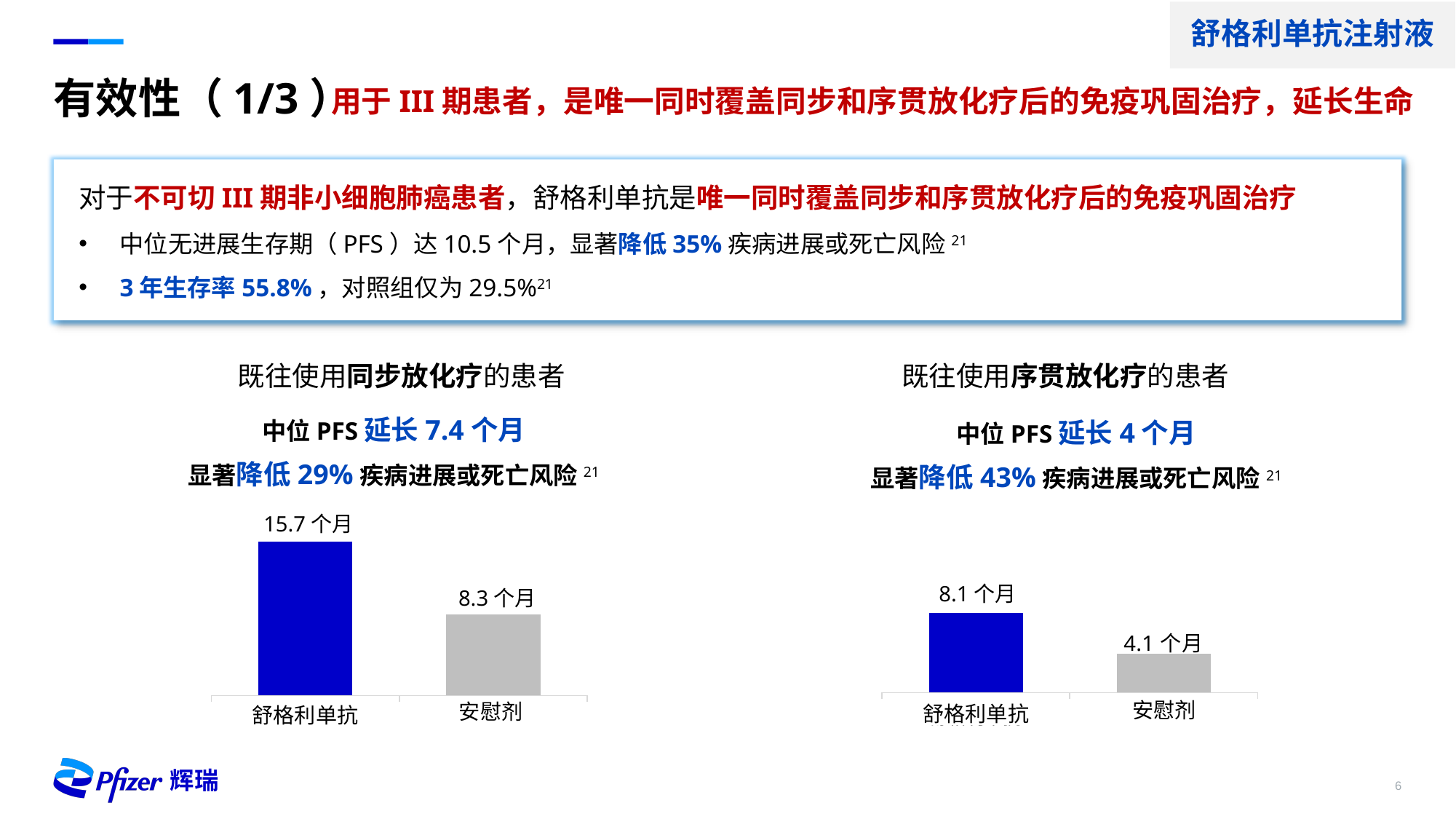
In the right chart (既往使用序贯放化疗的患者), what is the value for 舒格利单抗? 8.1 个月 What kind of chart is the right chart (既往使用序贯放化疗的患者)? bar chart In the left chart (既往使用同步放化疗的患者), what is the value for 安慰剂? 8.3 个月 In the left chart (既往使用同步放化疗的患者), what is the value for 舒格利单抗? 15.7 个月 In the right chart (既往使用序贯放化疗的患者), what is the difference between 舒格利单抗 and 安慰剂? 4 个月 In the right chart (既往使用序贯放化疗的患者), which is larger, 舒格利单抗 or 安慰剂? 舒格利单抗 In the left chart (既往使用同步放化疗的患者), which category has the highest value? 舒格利单抗 In the right chart (既往使用序贯放化疗的患者), what is the value for 安慰剂? 4.1 个月 How many bars are shown in the left chart (既往使用同步放化疗的患者)? 2 In the left chart (既往使用同步放化疗的患者), what colour is the bar for 舒格利单抗? blue In the right chart (既往使用序贯放化疗的患者), which category has the lowest value? 安慰剂 In the left chart (既往使用同步放化疗的患者), what is the difference between 舒格利单抗 and 安慰剂? 7.4 个月